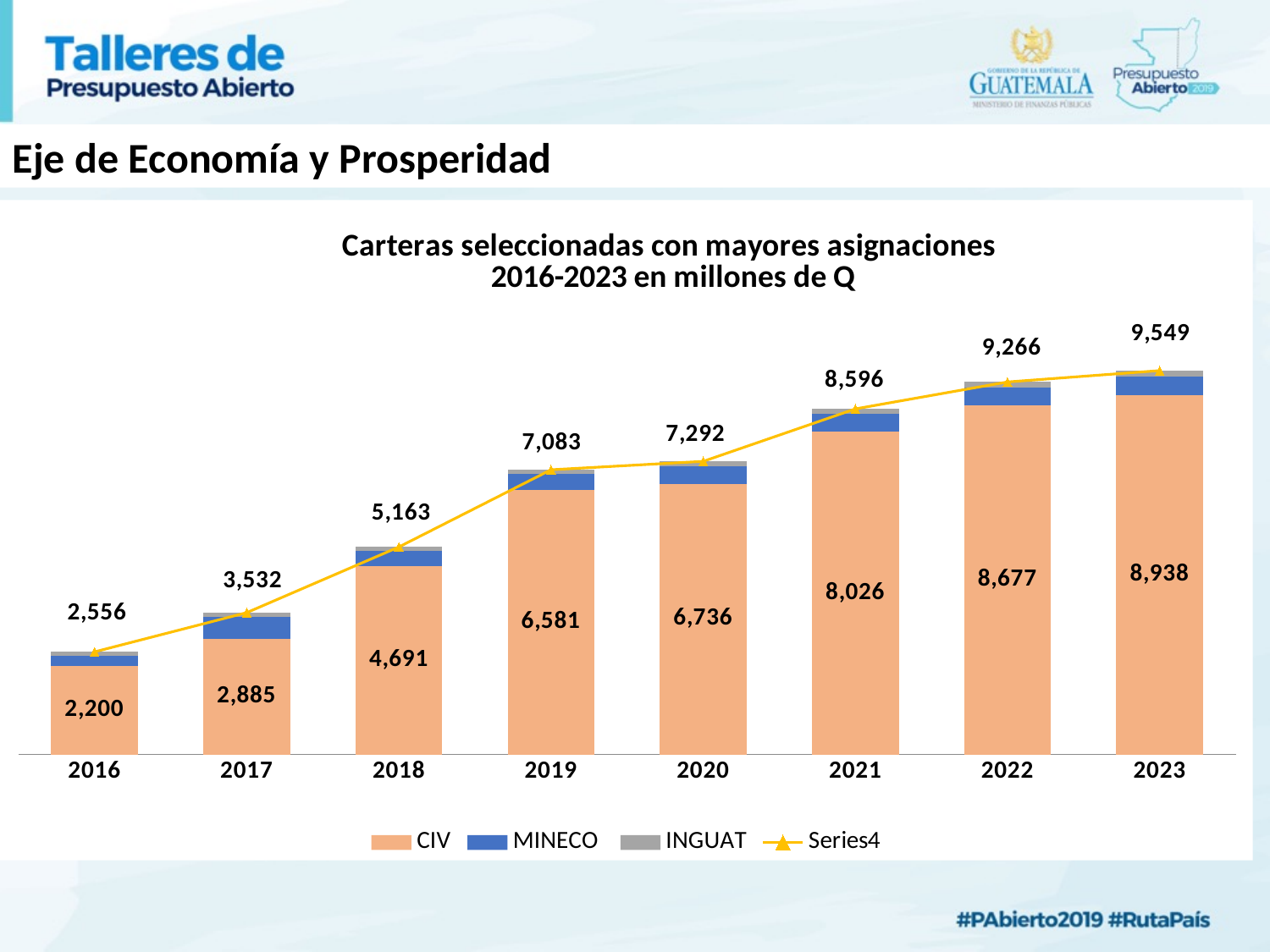
In which year is the Series4 value lowest? 2016 How many series does the legend list? 4 How many years are shown on the x axis? 8 Which year has the larger CIV value, 2019 or 2020? 2020 What is the difference between the Series4 values for 2022 and 2021? 670 In which year is the CIV value highest? 2023 What kind of chart is shown on the slide? Stacked bar chart with a line What is the Series4 value for 2021? 8,596 Do the Series4 values rise or fall from 2016 to 2023? Rise What is the difference between the CIV values for 2023 and 2016? 6,738 What is the CIV value for 2020? 6,736 What is the CIV value for 2018? 4,691